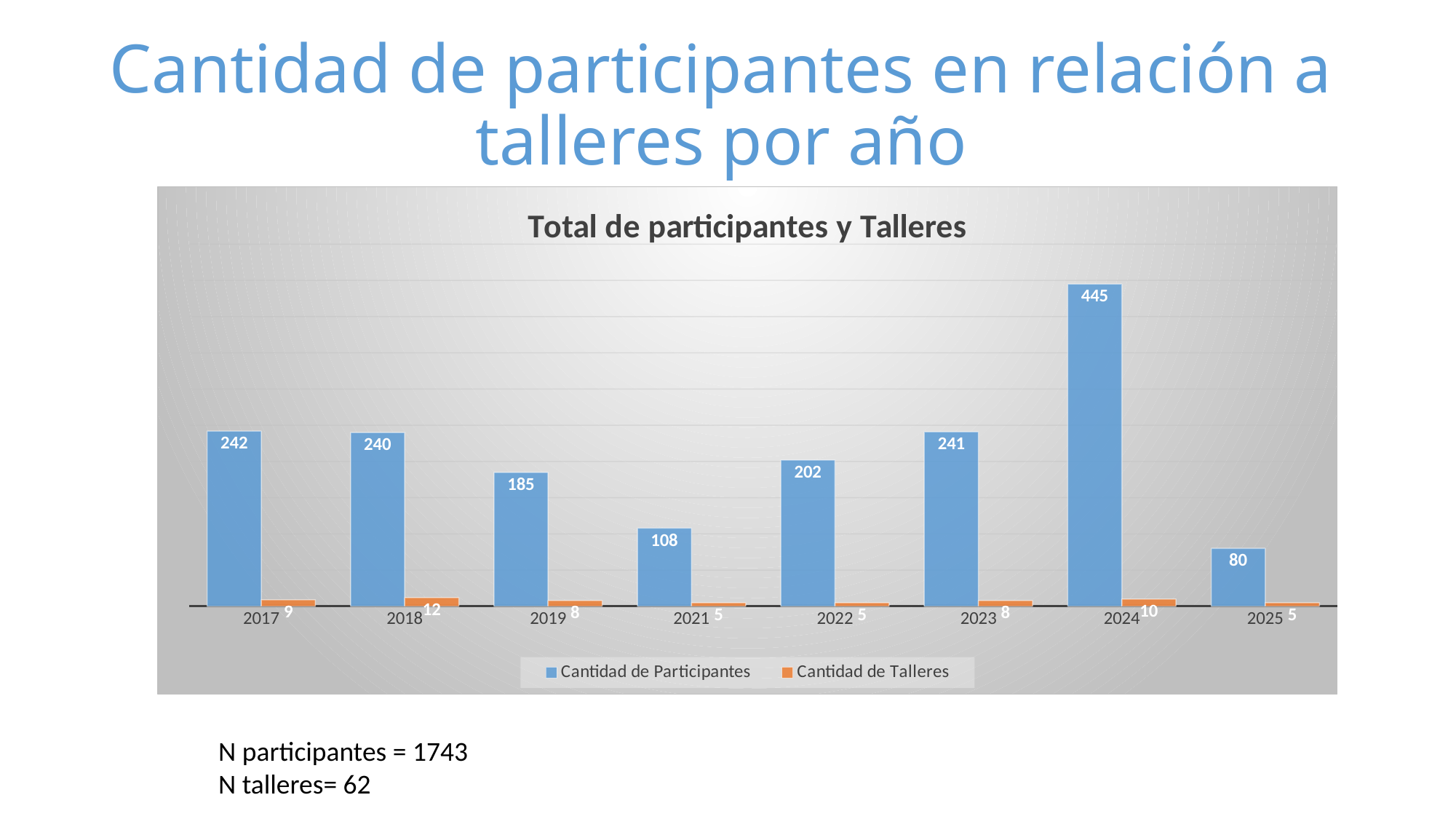
What is the value of Cantidad de Talleres for 2018? 12 Which year has the lowest Cantidad de Participantes? 2025 What is the value of Cantidad de Participantes for 2024? 445 Which year has the highest Cantidad de Talleres? 2018 What is the difference in Cantidad de Participantes between 2024 and 2025? 365 How many years are shown on the x axis? 8 Which is larger, the Cantidad de Participantes for 2019 or for 2022? 2022 How many series does the legend list? 2 Which year has the highest Cantidad de Participantes? 2024 What is the title of the chart? Total de participantes y Talleres What kind of chart is shown? Bar chart What is the value of Cantidad de Participantes for 2021? 108